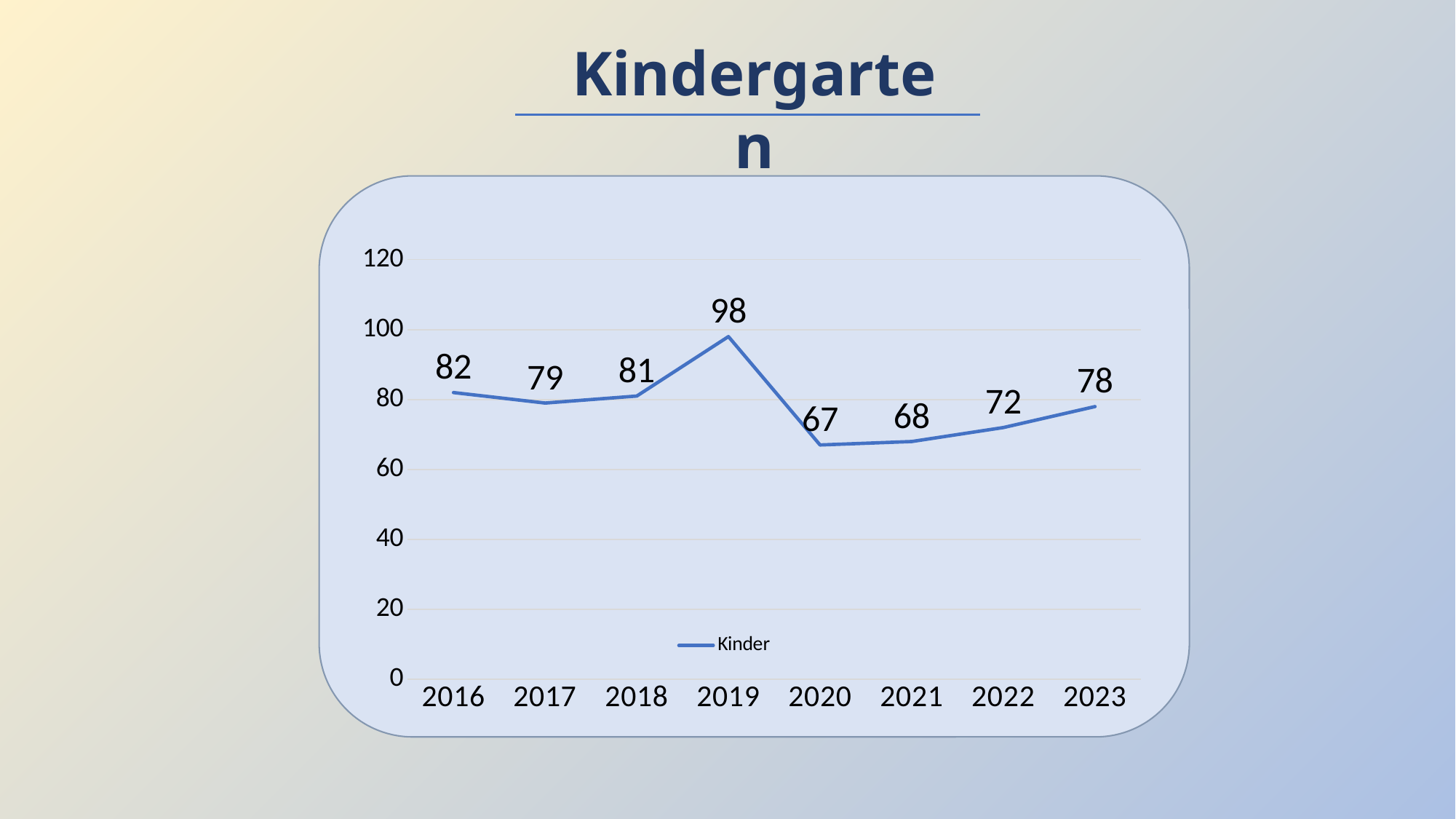
What is the difference between the values for 2019 and 2020? 31 What kind of chart is shown? line chart Which is larger, the value for 2017 or the value for 2023? 2017 What is the value for 2019? 98 What is the name of the series in the legend? Kinder Which year has the lowest value? 2020 How many years are shown on the x axis? 8 What is the value for 2016? 82 Is the value for 2022 greater or less than 80? less How many series does the legend list? 1 Which year has the highest value? 2019 What is the value for 2020? 67